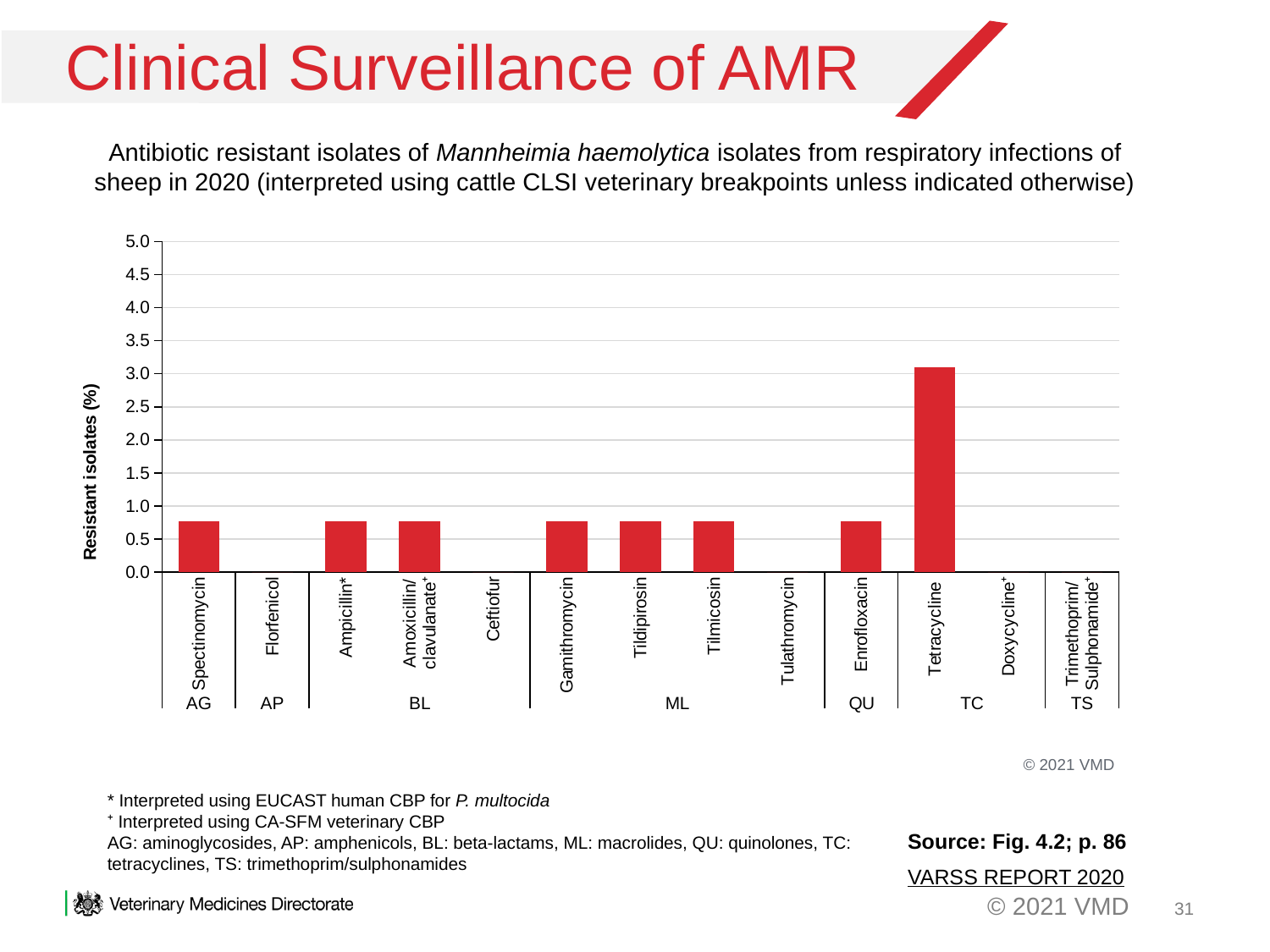
Is the value for Tetracycline greater or less than 2.5? greater How many antibiotics are shown on the x axis of the chart? 13 Is the value for Spectinomycin greater or less than 1.0? less Which antibiotic has the highest percentage of resistant isolates? Tetracycline Which has the larger value, Gamithromycin or Tulathromycin? Gamithromycin What is the label of the y axis? Resistant isolates (%) Which has the larger value, Tetracycline or Enrofloxacin? Tetracycline What kind of chart is shown on the slide? bar chart Which has the larger value, Ampicillin* or Ceftiofur? Ampicillin* Is the value for Enrofloxacin greater or less than 0.5? greater How many antibiotic class groups (such as AG, AP, BL) are labelled along the x axis? 7